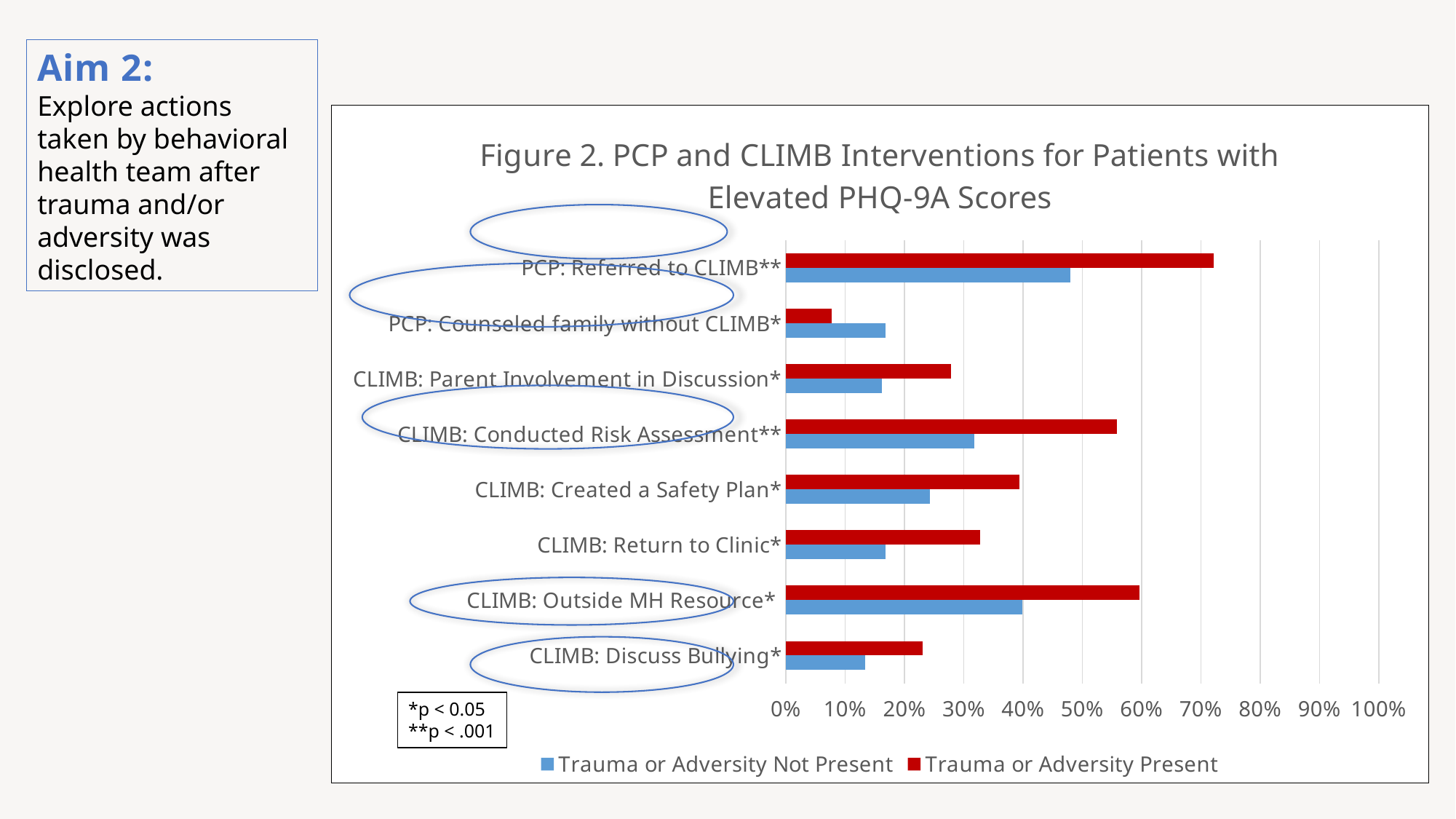
For PCP: Counseled family without CLIMB*, which series has the larger value, Trauma or Adversity Present or Trauma or Adversity Not Present? Trauma or Adversity Not Present Is the Trauma or Adversity Present value for PCP: Counseled family without CLIMB* greater or less than 10%? less How many series does the legend of Figure 2 list? 2 Is the Trauma or Adversity Present value for PCP: Referred to CLIMB** greater or less than 60%? greater Which intervention has the lowest value for the Trauma or Adversity Present series? PCP: Counseled family without CLIMB* For CLIMB: Conducted Risk Assessment**, which series has the larger value, Trauma or Adversity Present or Trauma or Adversity Not Present? Trauma or Adversity Present How many intervention categories are plotted in Figure 2? 8 Which colour represents the Trauma or Adversity Present series in Figure 2? red Which intervention has the highest value for the Trauma or Adversity Not Present series? PCP: Referred to CLIMB** What kind of chart is shown in Figure 2? bar chart Is the Trauma or Adversity Not Present value for CLIMB: Created a Safety Plan* greater or less than 30%? less Which intervention has the highest value for the Trauma or Adversity Present series? PCP: Referred to CLIMB**